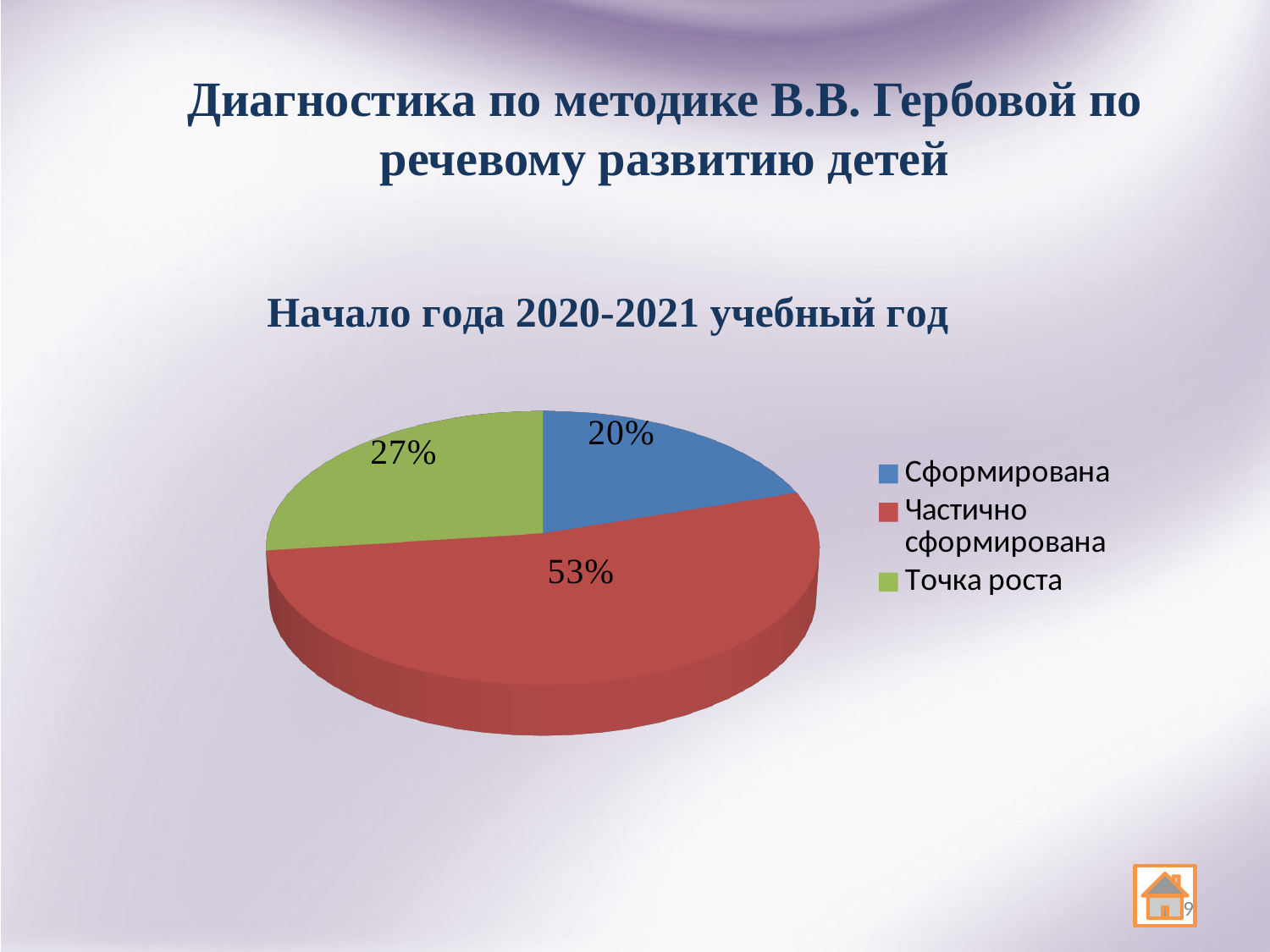
What share of the pie does "Частично сформирована" have? 53% Which category has the smallest slice of the pie? Сформирована What is the difference in percentage points between "Точка роста" and "Сформирована"? 7 What share of the pie does "Точка роста" have? 27% What is the difference in percentage points between "Частично сформирована" and "Точка роста"? 26 What kind of chart is shown on the slide? pie chart What colour is the slice for "Частично сформирована"? red What is the title shown above the pie chart? Начало года 2020-2021 учебный год What share of the pie does "Сформирована" have? 20% Which category has the largest slice of the pie? Частично сформирована Which is larger, the slice for "Точка роста" or the slice for "Сформирована"? Точка роста How many slices does the pie chart have? 3